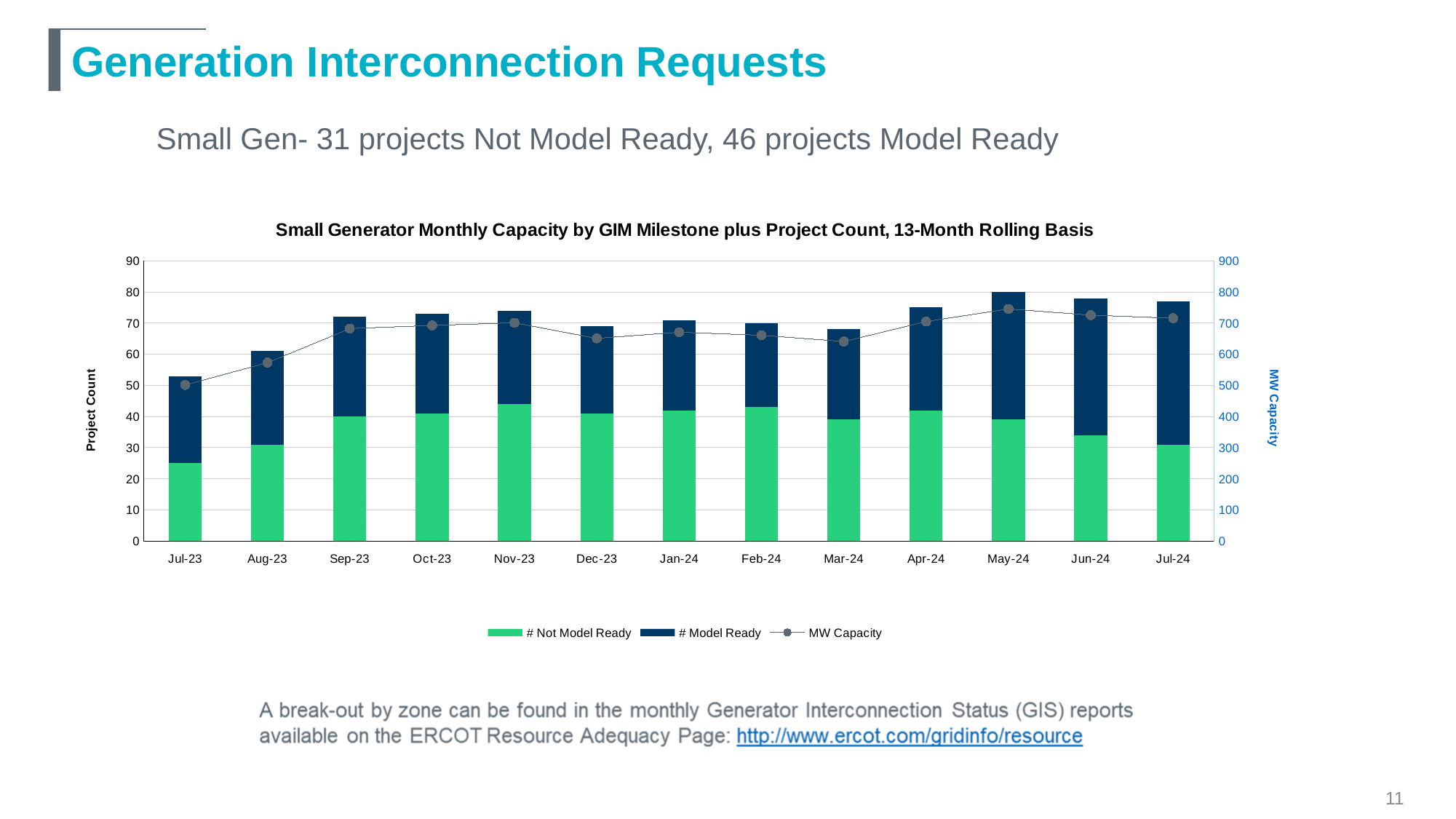
Which month has the lowest total project count? Jul-23 According to the slide, how many Small Gen projects are Model Ready in Jul-24? 46 Which month has the lowest MW Capacity? Jul-23 What type of chart is shown on the slide? Bar chart (stacked bars with a line) Is the total project count for Jul-23 greater or less than 60? less What is the total project count for Jul-24 (Not Model Ready plus Model Ready)? 77 How many months are shown on the x axis of the chart? 13 According to the slide, how many Small Gen projects are Not Model Ready in Jul-24? 31 Is the MW Capacity for Dec-23 greater or less than 700? less How many series does the chart legend list? 3 Does the MW Capacity rise or fall from Jul-23 to Nov-23? rise Which month has the highest total project count? May-24